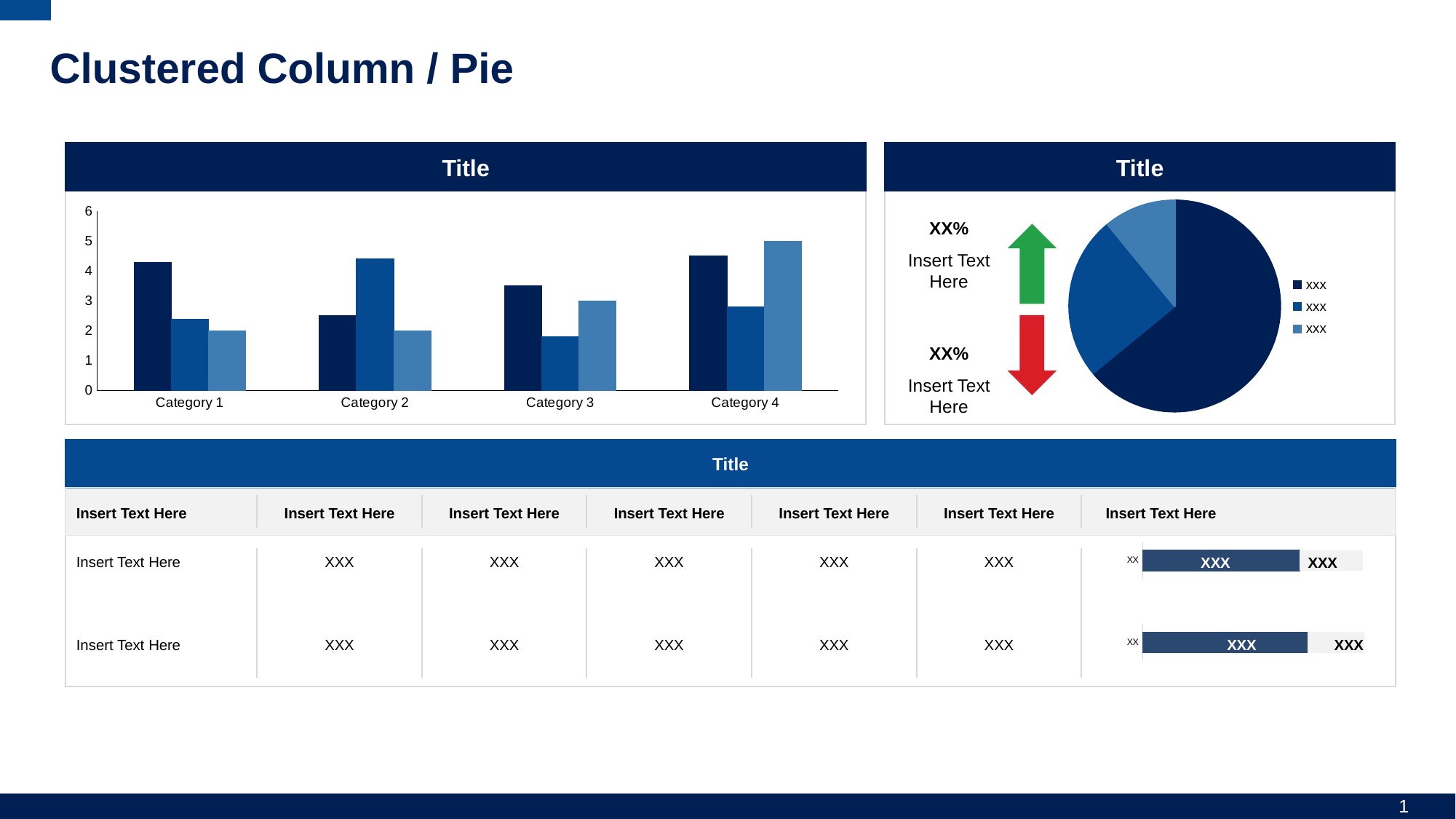
In the pie chart on the right, which slice is the largest? the dark navy slice In the bar chart on the left, which category contains the tallest bar overall? Category 4 What kind of chart is shown on the left of the slide? bar chart In the bar chart on the left, how many categories are shown on the x axis? 4 In the bar chart on the left, is the value of the lightest bar for Category 4 greater or less than 4? greater In the bar chart on the left, is the value of the darkest bar for Category 2 greater or less than 3? less In the bar chart on the left, for Category 1, which is larger: the darkest bar or the lightest bar? the darkest bar In the bar chart on the left, is the value of the darkest bar for Category 1 greater or less than 3? greater What kind of chart is shown on the right of the slide? pie chart In the bar chart on the left, how many bars are shown for each category? 3 How many entries does the legend of the pie chart on the right list? 3